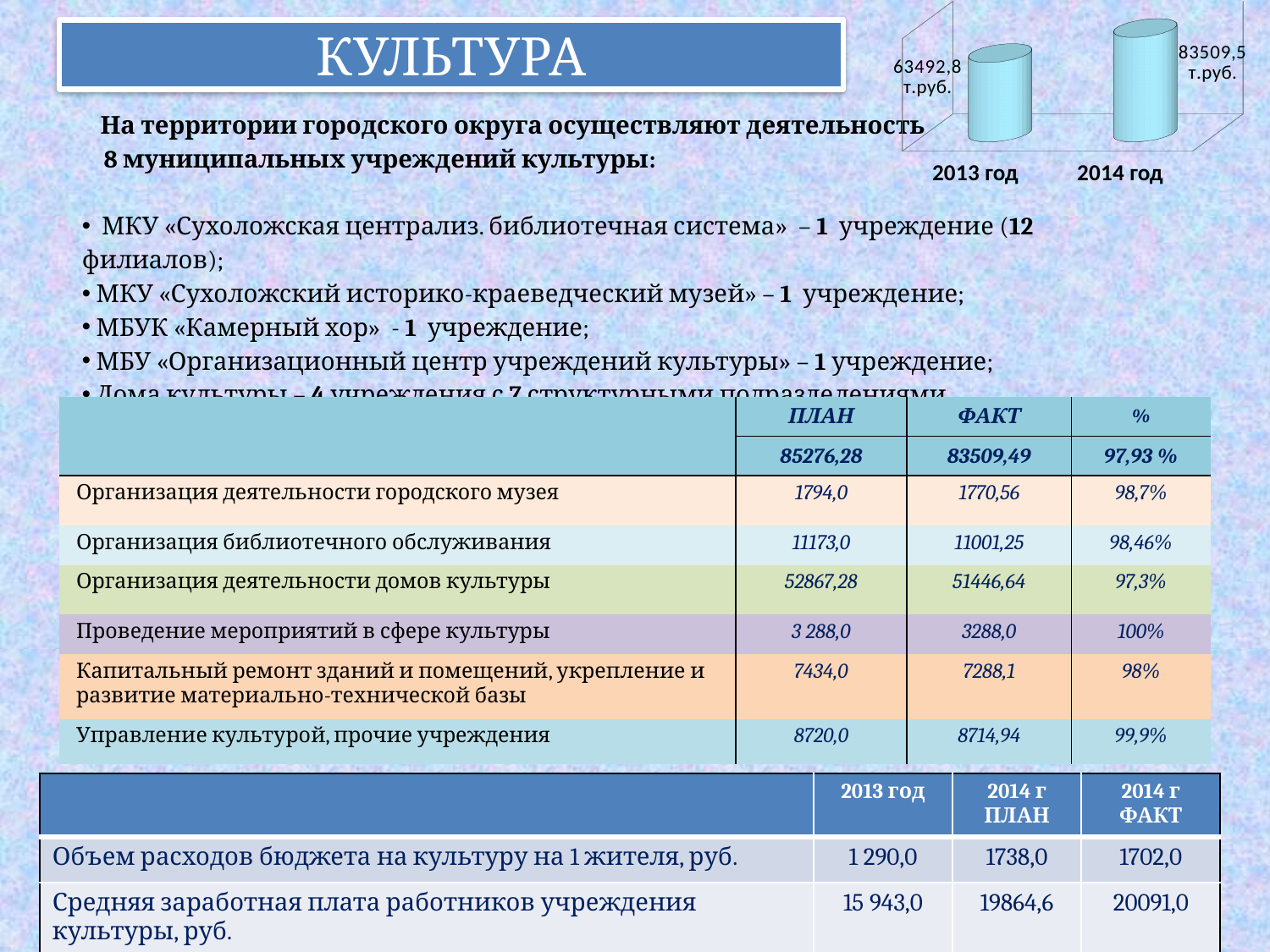
In the bar chart at the top right of the slide, by how much does the 2014 год value exceed the 2013 год value? 20016,7 т.руб. In what units are the values labelled in the bar chart at the top right of the slide? т.руб. In the bar chart at the top right of the slide, which year has the higher value? 2014 год In the bar chart at the top right of the slide, what is the value for 2013 год? 63492,8 т.руб. Which two categories are shown on the x axis of the bar chart at the top right of the slide? 2013 год and 2014 год In the bar chart at the top right of the slide, which year has the lower value? 2013 год What kind of chart is shown at the top right of the slide? bar chart In the bar chart at the top right of the slide, what is the value for 2014 год? 83509,5 т.руб. How many bars are shown in the bar chart at the top right of the slide? 2 In the bar chart at the top right of the slide, is the value for 2013 год larger or smaller than the value for 2014 год? smaller In the bar chart at the top right of the slide, do the values rise or fall from 2013 год to 2014 год? rise